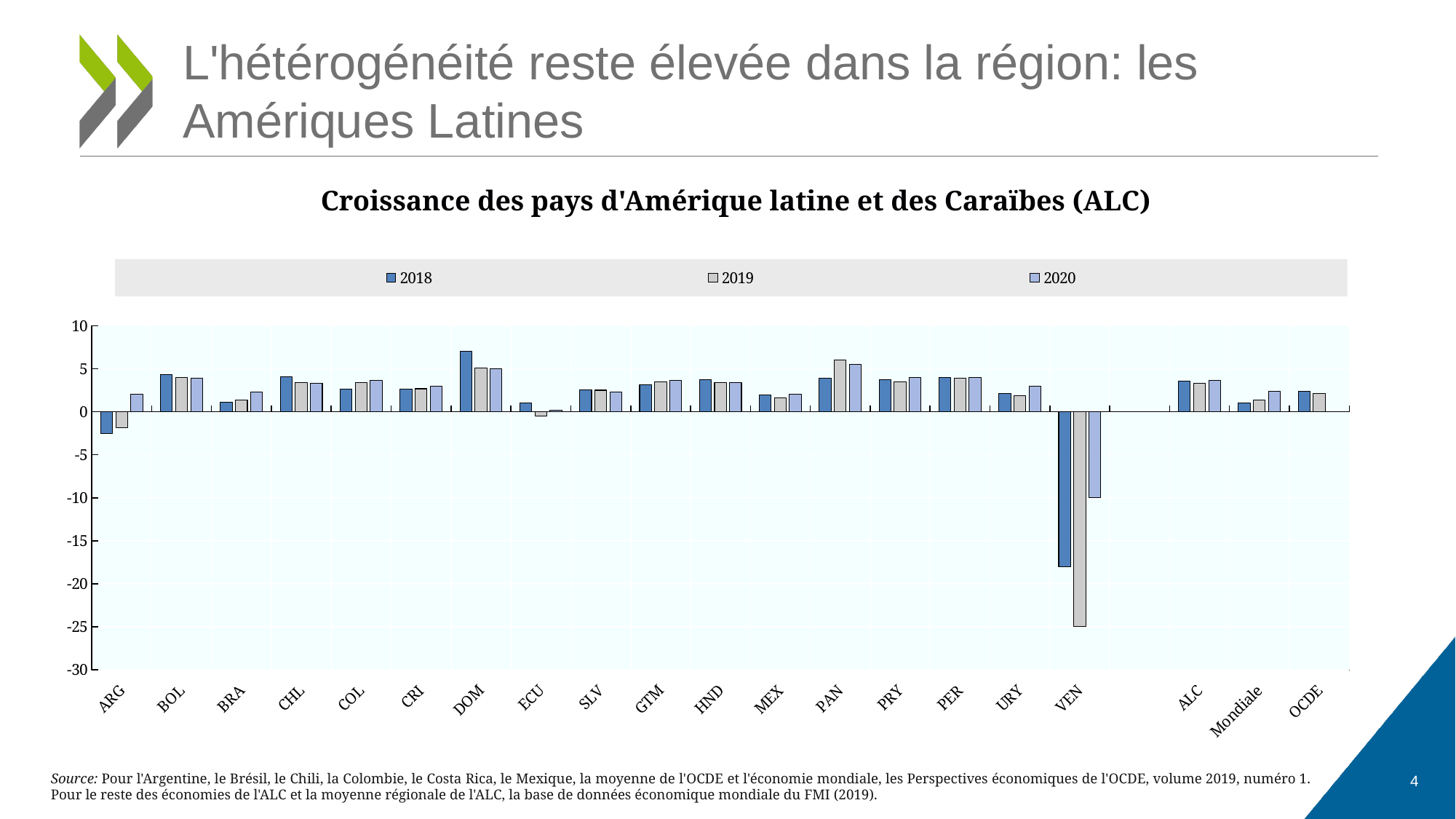
For ARG, which is larger: the 2018 value or the 2020 value? 2020 For VEN, which is larger: the 2018 value or the 2019 value? 2018 Is the 2018 value for DOM greater or less than 5? greater Is the 2020 value for VEN greater or less than -5? less How many categories are shown on the x axis? 20 Which category has the lowest value for 2019? VEN What is the title of the chart? Croissance des pays d'Amérique latine et des Caraïbes (ALC) What kind of chart is shown on the slide? bar chart Is the 2019 value for VEN greater or less than -20? less Which category has the highest value for 2018? DOM How many series does the legend list? 3